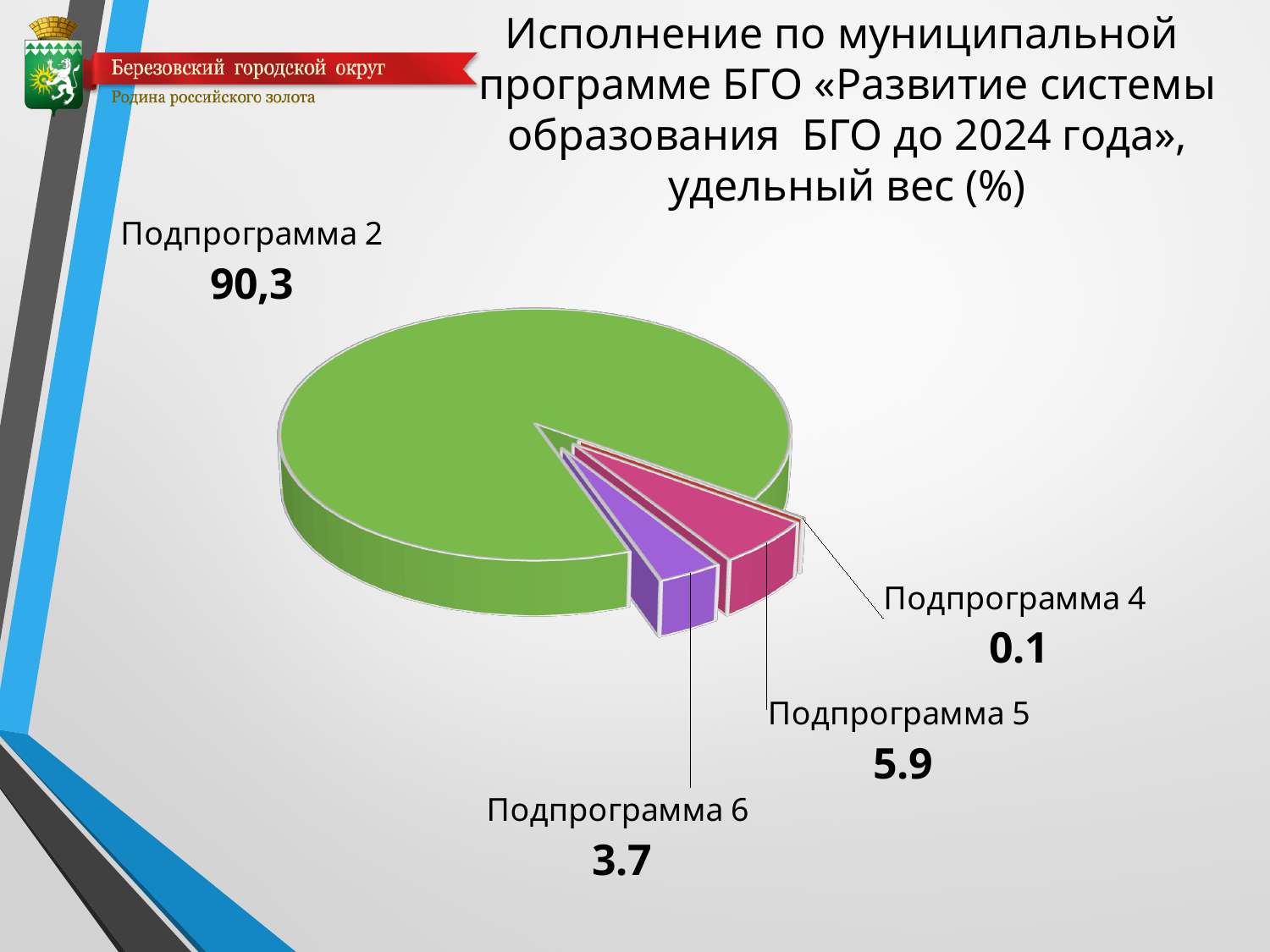
What is the value shown for Подпрограмма 2? 90,3 What is the value shown for Подпрограмма 4? 0.1 Which is larger, the value for Подпрограмма 5 or the value for Подпрограмма 6? Подпрограмма 5 What is the difference between the values for Подпрограмма 5 and Подпрограмма 6? 2.2 What is the value shown for Подпрограмма 5? 5.9 Which subprogram has the smallest slice of the pie? Подпрограмма 4 What colour is the slice for Подпрограмма 2? Green What is the difference between the values for Подпрограмма 6 and Подпрограмма 4? 3.6 Which subprogram has the largest slice of the pie? Подпрограмма 2 What kind of chart is shown on the slide? Pie chart How many slices does the pie chart have? 4 What is the value shown for Подпрограмма 6? 3.7